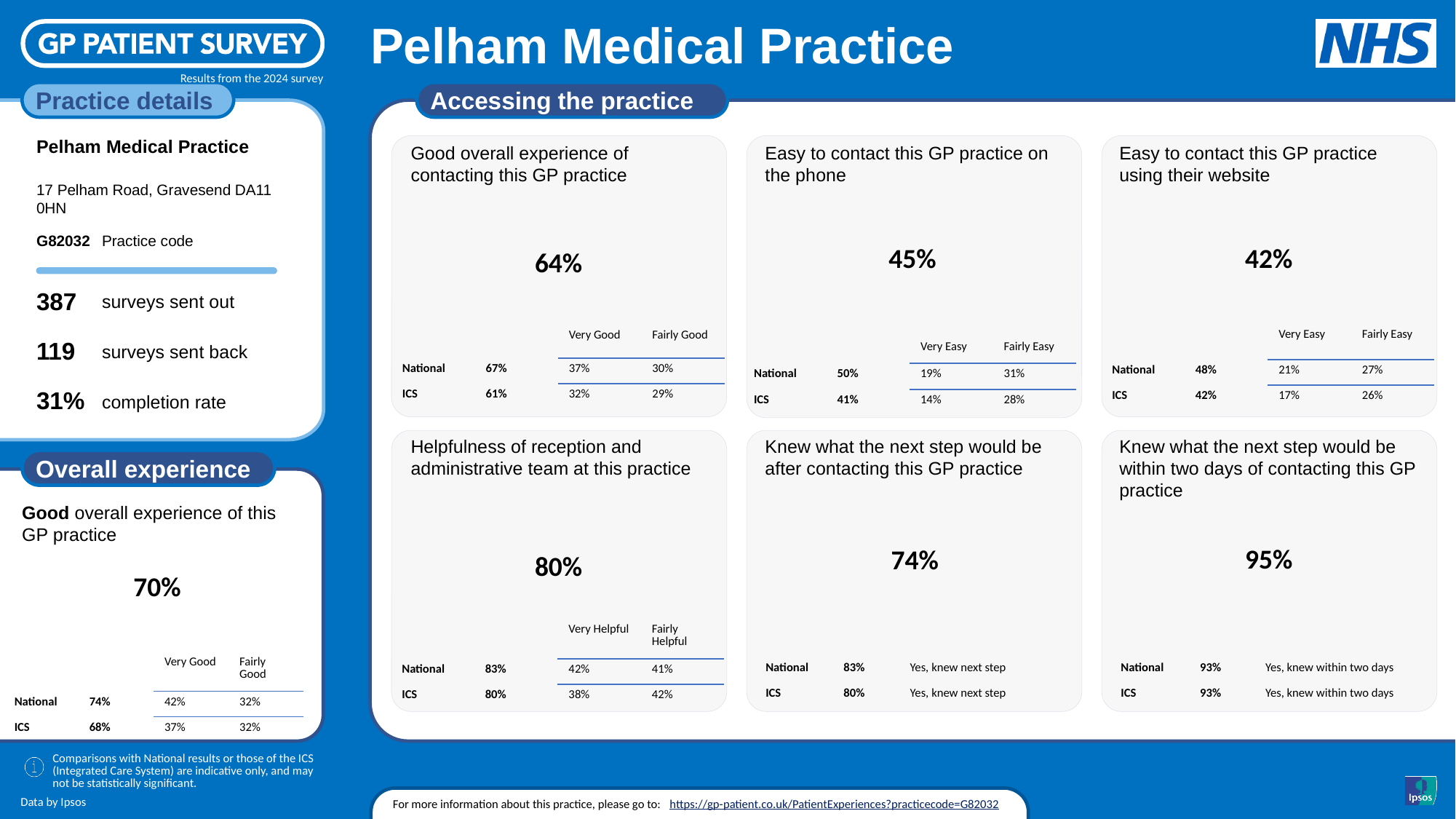
In the 'Knew what the next step would be within two days of contacting this GP practice' panel, what is the practice's value? 95% In the 'Good overall experience of contacting this GP practice' panel, what is the practice's value? 64% In the 'Good overall experience of this GP practice' panel, what is the difference between the National value and the ICS value? 6% In the 'Easy to contact this GP practice using their website' panel, what is the National 'Very Easy' value? 21% In the 'Easy to contact this GP practice using their website' panel, what is the National value? 48% In the 'Helpfulness of reception and administrative team at this practice' panel, what is the ICS value? 80% Among the six 'Accessing the practice' panels, which has the highest practice value? Knew what the next step would be within two days of contacting this GP practice Among the six 'Accessing the practice' panels, which has the lowest practice value? Easy to contact this GP practice using their website In the 'Knew what the next step would be after contacting this GP practice' panel, what is the difference between the National value and the practice's value? 9% In the 'Good overall experience of this GP practice' panel under Overall experience, what is the practice's value? 70% In the 'Easy to contact this GP practice on the phone' panel, which is larger: the practice's value or the National value? National In the 'Easy to contact this GP practice on the phone' panel, what is the practice's value? 45%